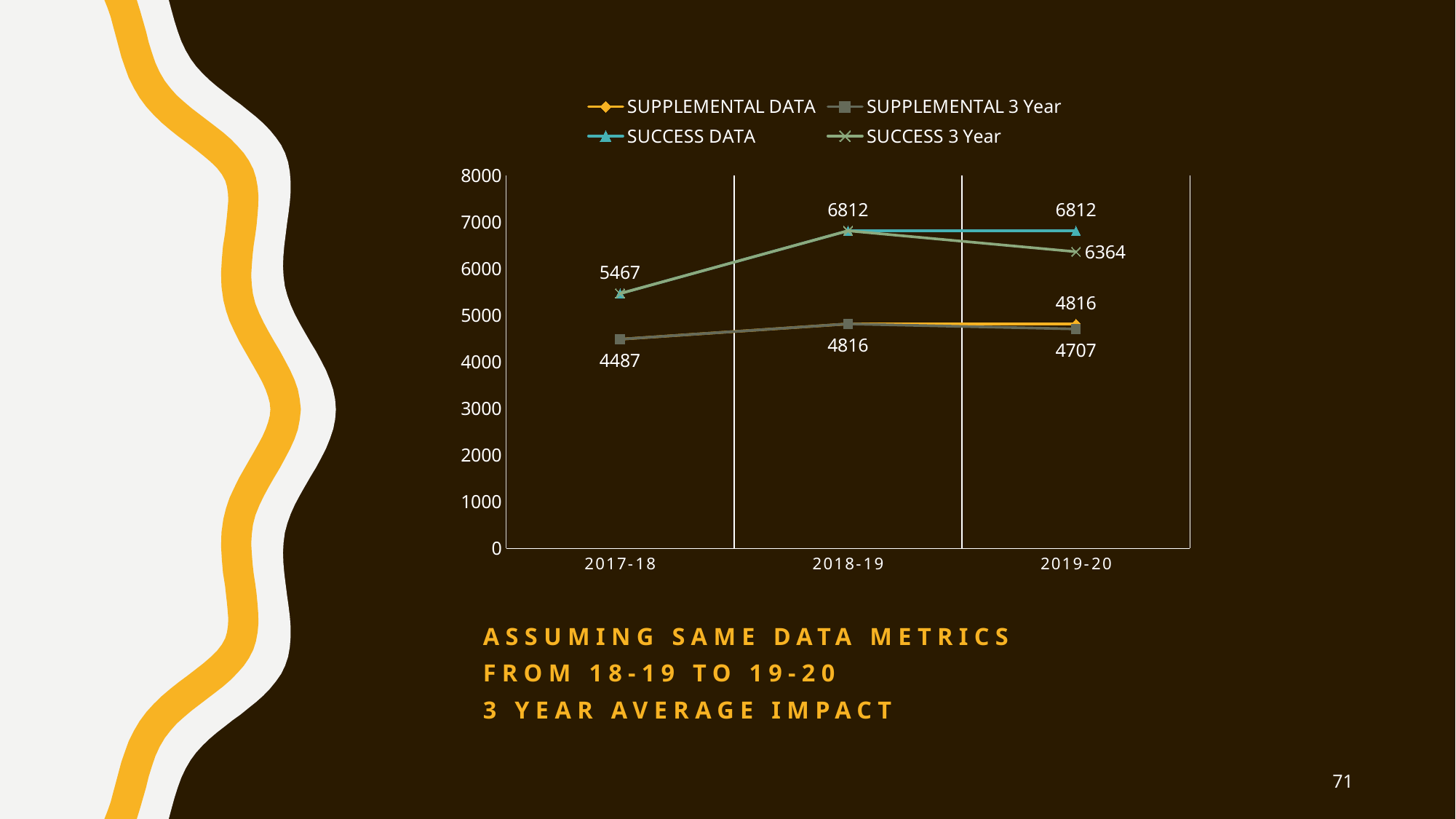
How many categories are shown on the x axis? 3 Does the SUCCESS series rise or fall from 2017-18 to 2018-19? rise What is the difference between SUPPLEMENTAL DATA and SUPPLEMENTAL 3 Year in 2019-20? 109 What is the value of SUCCESS 3 Year for 2019-20? 6364 How many series does the legend list? 4 What is the value of SUCCESS DATA for 2019-20? 6812 Which is larger in 2019-20, SUCCESS DATA or SUCCESS 3 Year? SUCCESS DATA What is the value of SUPPLEMENTAL DATA for 2019-20? 4816 What type of chart is shown on the slide? line chart What is the value labelled for the SUCCESS series in 2017-18? 5467 What is the value of SUPPLEMENTAL 3 Year for 2019-20? 4707 What is the difference between SUCCESS DATA and SUCCESS 3 Year in 2019-20? 448